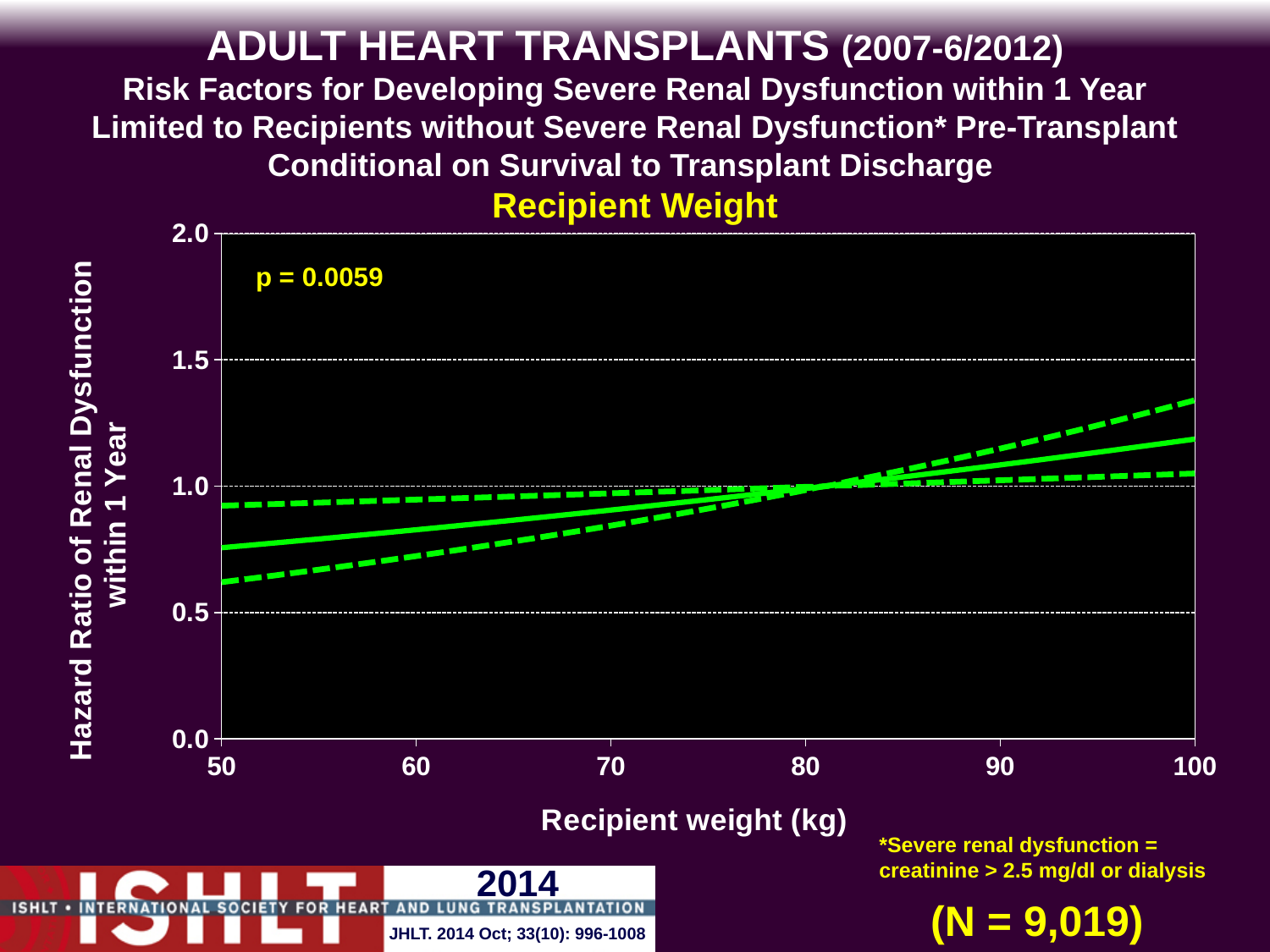
Is the upper dashed line at a recipient weight of 100 kg greater or less than 1.5? less How many tick labels are shown on the x axis? 6 What is the label of the x axis? Recipient weight (kg) What p-value is printed on the chart? p = 0.0059 How many lines are plotted on the chart? 3 What is the highest value labelled on the y axis? 2.0 Is the lower dashed line at a recipient weight of 50 kg greater or less than 0.5? greater Is the hazard ratio on the solid line larger at a recipient weight of 50 kg or at 100 kg? 100 kg Is the hazard ratio on the solid line at a recipient weight of 50 kg greater or less than 1.0? less What kind of chart is shown on the slide? line chart Does the hazard ratio (solid line) rise or fall as recipient weight increases from 50 to 100 kg? rise